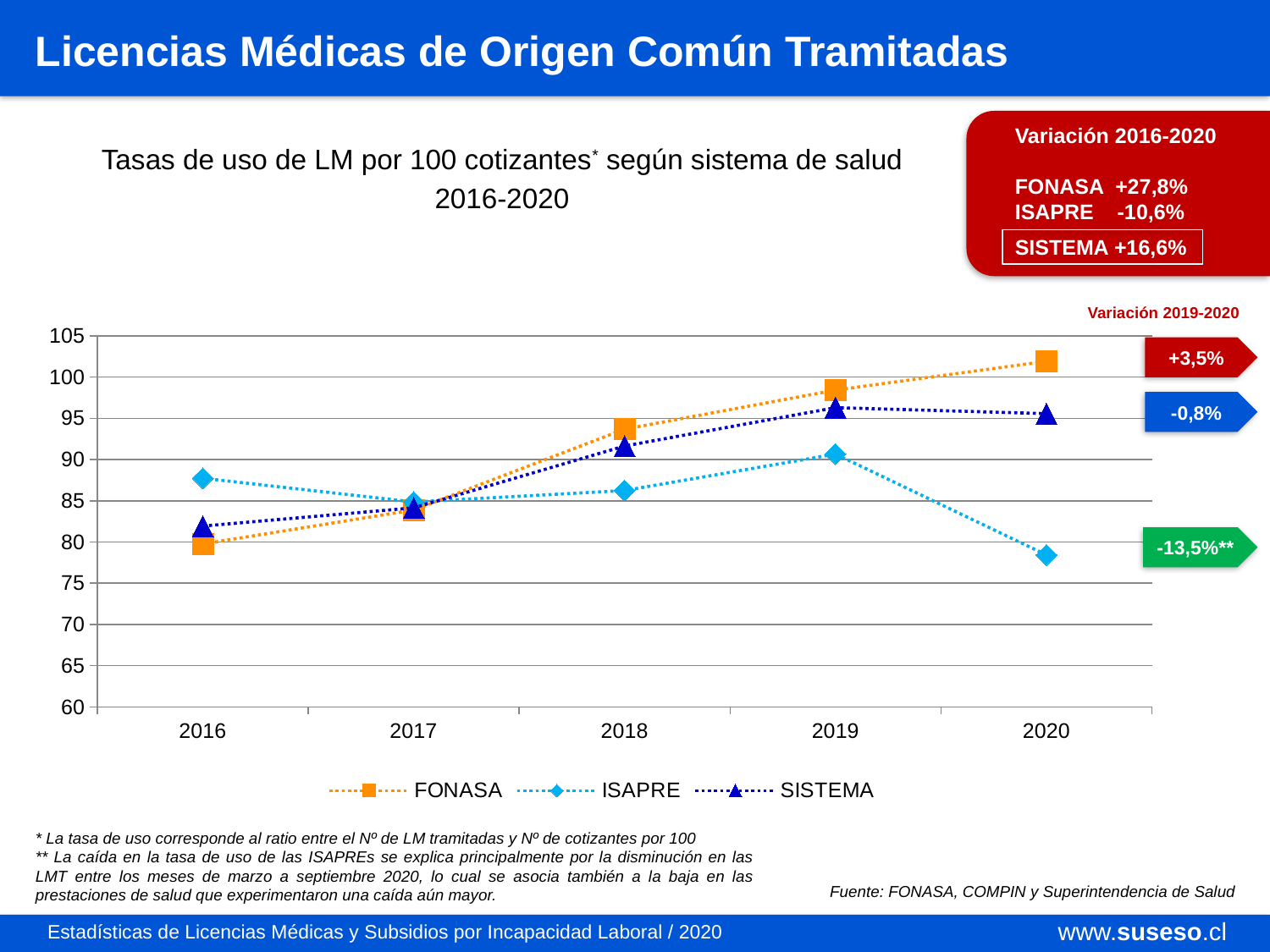
Is the value for FONASA in 2020 greater or less than 100? greater Does the FONASA series rise or fall from 2016 to 2020? rise Which series has the highest value in 2016? ISAPRE Which series has the lowest value in 2020? ISAPRE What kind of chart is shown on the slide? line chart Which is larger in 2019, the value for FONASA or the value for ISAPRE? FONASA According to the box on the slide, what is the 2016-2020 variation for SISTEMA? +16,6% How many years are plotted along the x axis? 5 Is the value for ISAPRE in 2020 greater or less than 80? less Is the value for FONASA in 2018 greater or less than 95? less Which series has the highest value in 2020? FONASA How many series does the chart legend list? 3